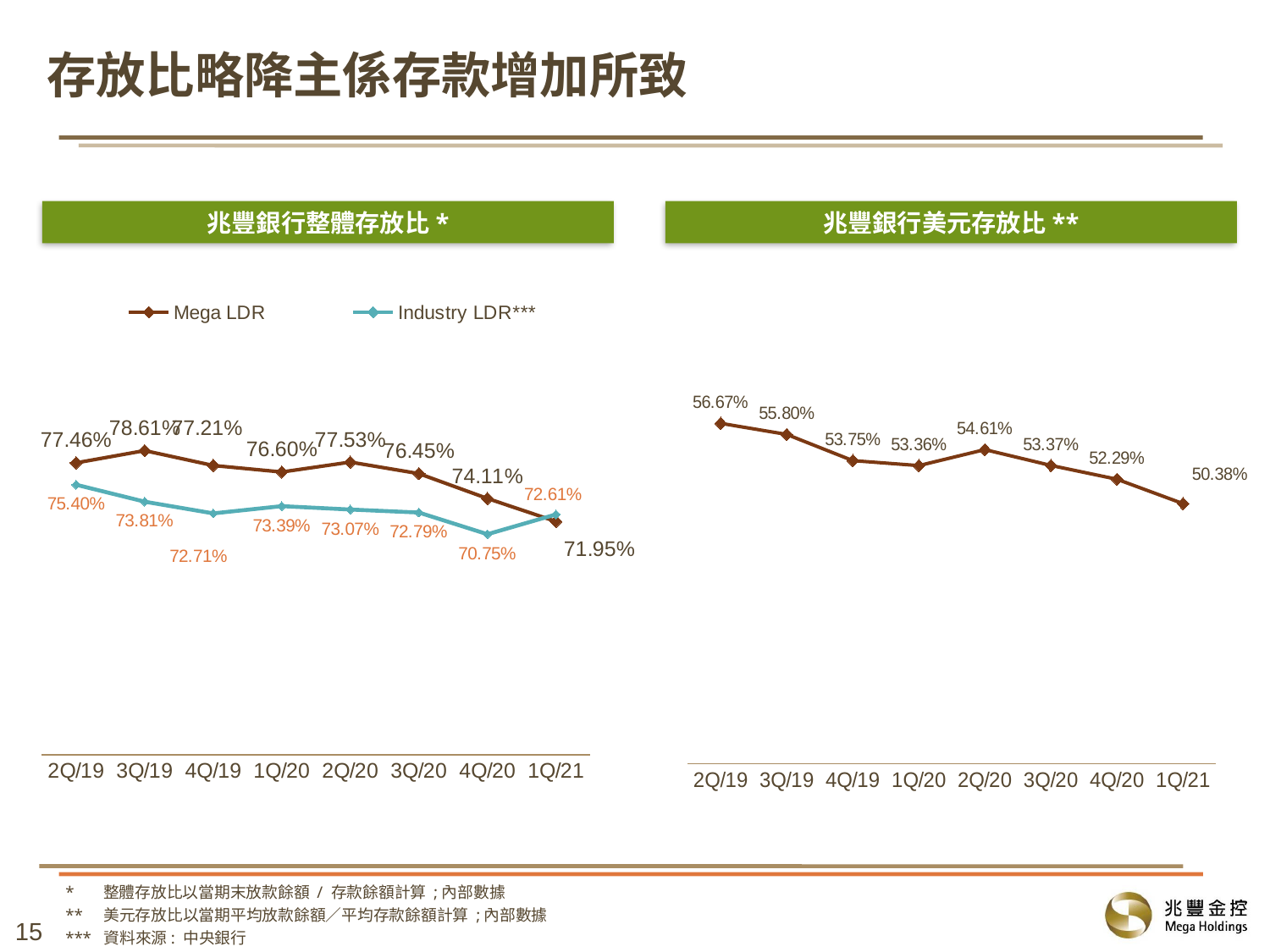
How many series does the legend of the left chart (兆豐銀行整體存放比) list? 2 In the left chart (兆豐銀行整體存放比), what is the Mega LDR value for 3Q/19? 78.61% In the right chart (兆豐銀行美元存放比), what is the value for 1Q/21? 50.38% What type of chart is the right chart (兆豐銀行美元存放比)? Line chart In the right chart (兆豐銀行美元存放比), which quarter has the highest value? 2Q/19 In the right chart (兆豐銀行美元存放比), does the value overall rise or fall from 2Q/19 to 1Q/21? Fall In the left chart (兆豐銀行整體存放比), what is the difference between the Mega LDR and the Industry LDR in 2Q/19? 2.06 percentage points In the left chart (兆豐銀行整體存放比), which is larger in 4Q/20, the Mega LDR or the Industry LDR? Mega LDR In the right chart (兆豐銀行美元存放比), by how much did the value fall from 2Q/19 to 1Q/21? 6.29 percentage points In the left chart (兆豐銀行整體存放比), in which quarter is the Mega LDR lowest? 1Q/21 How many quarters are plotted in the right chart (兆豐銀行美元存放比)? 8 In the left chart (兆豐銀行整體存放比), what is the Industry LDR value for 4Q/20? 70.75%